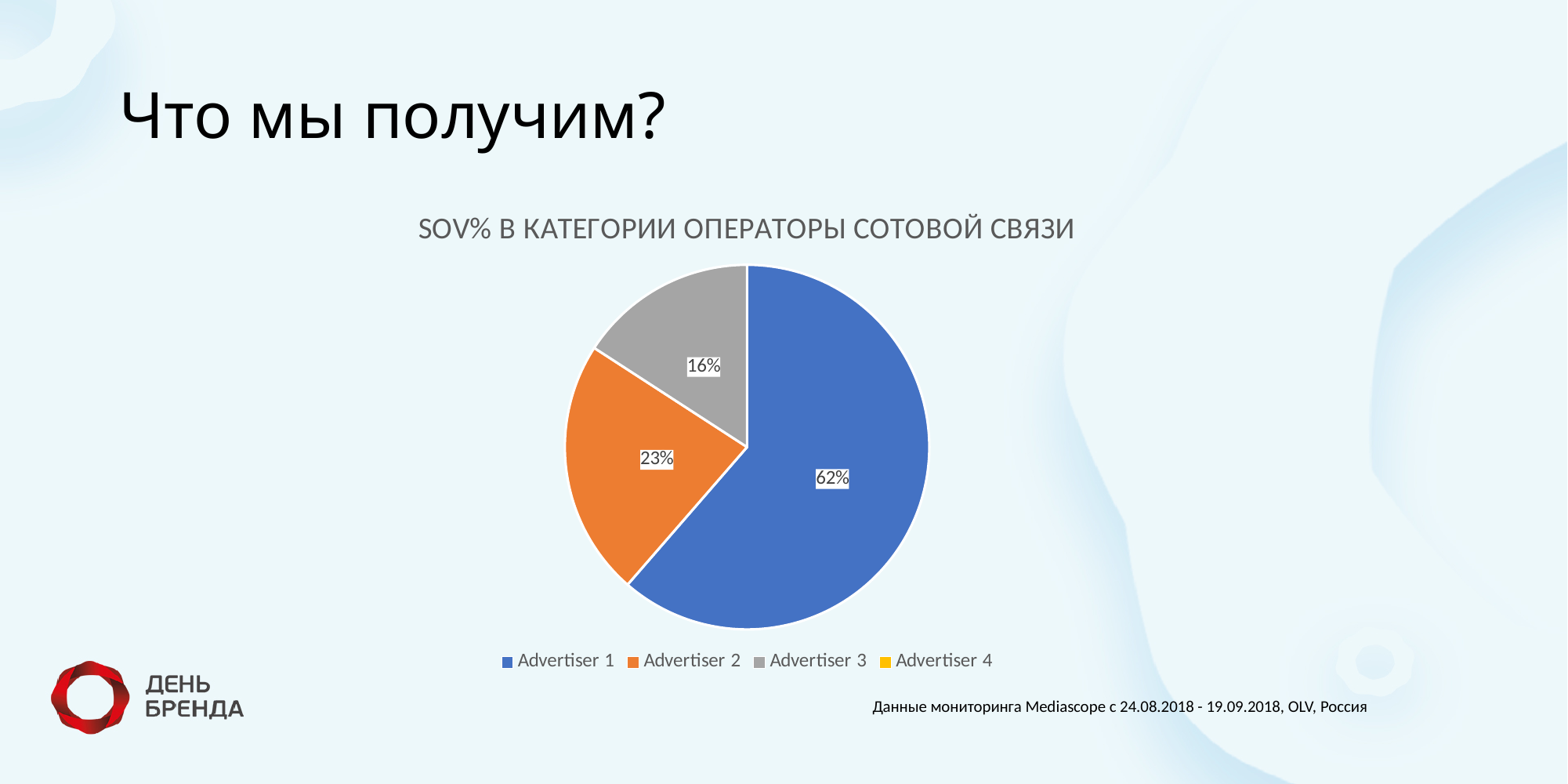
What share of the pie does Advertiser 2 have? 23% What is the difference in percentage points between Advertiser 2 and Advertiser 3? 7 Which advertiser has the largest share of the pie? Advertiser 1 What share of the pie does Advertiser 3 have? 16% How many entries does the chart legend list? 4 What colour is the slice for Advertiser 2? Orange What is the difference in percentage points between Advertiser 1 and Advertiser 2? 39 Which has the larger share, Advertiser 2 or Advertiser 3? Advertiser 2 What type of chart is shown on the slide? Pie chart What is the title of the chart? SOV% В КАТЕГОРИИ ОПЕРАТОРЫ СОТОВОЙ СВЯЗИ What is the difference in percentage points between Advertiser 1 and Advertiser 3? 46 What share of the pie does Advertiser 1 have? 62%